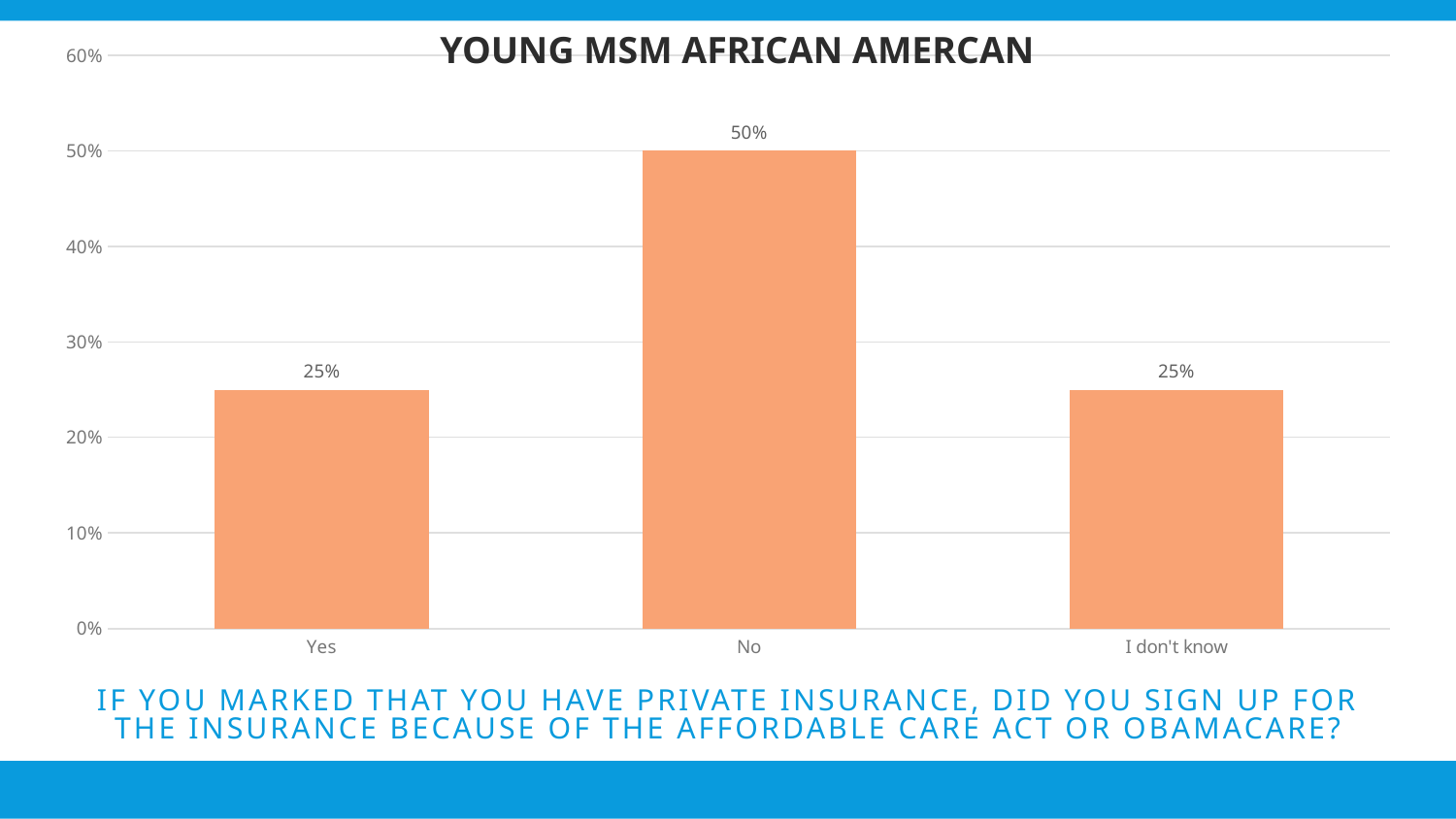
What is the value for "I don't know"? 25% Is the value for "Yes" greater or less than 30%? less What is the title of the chart? YOUNG MSM AFRICAN AMERCAN What is the value for "Yes"? 25% What is the highest value shown on the y axis? 60% Which category has the highest value? No What kind of chart is shown on the slide? Bar chart What is the value for "No"? 50% How many categories are shown on the x axis? 3 Is the value for "No" greater or less than 40%? greater What is the difference between the values for "No" and "Yes"? 25% Which is larger, the value for "No" or the value for "I don't know"? No